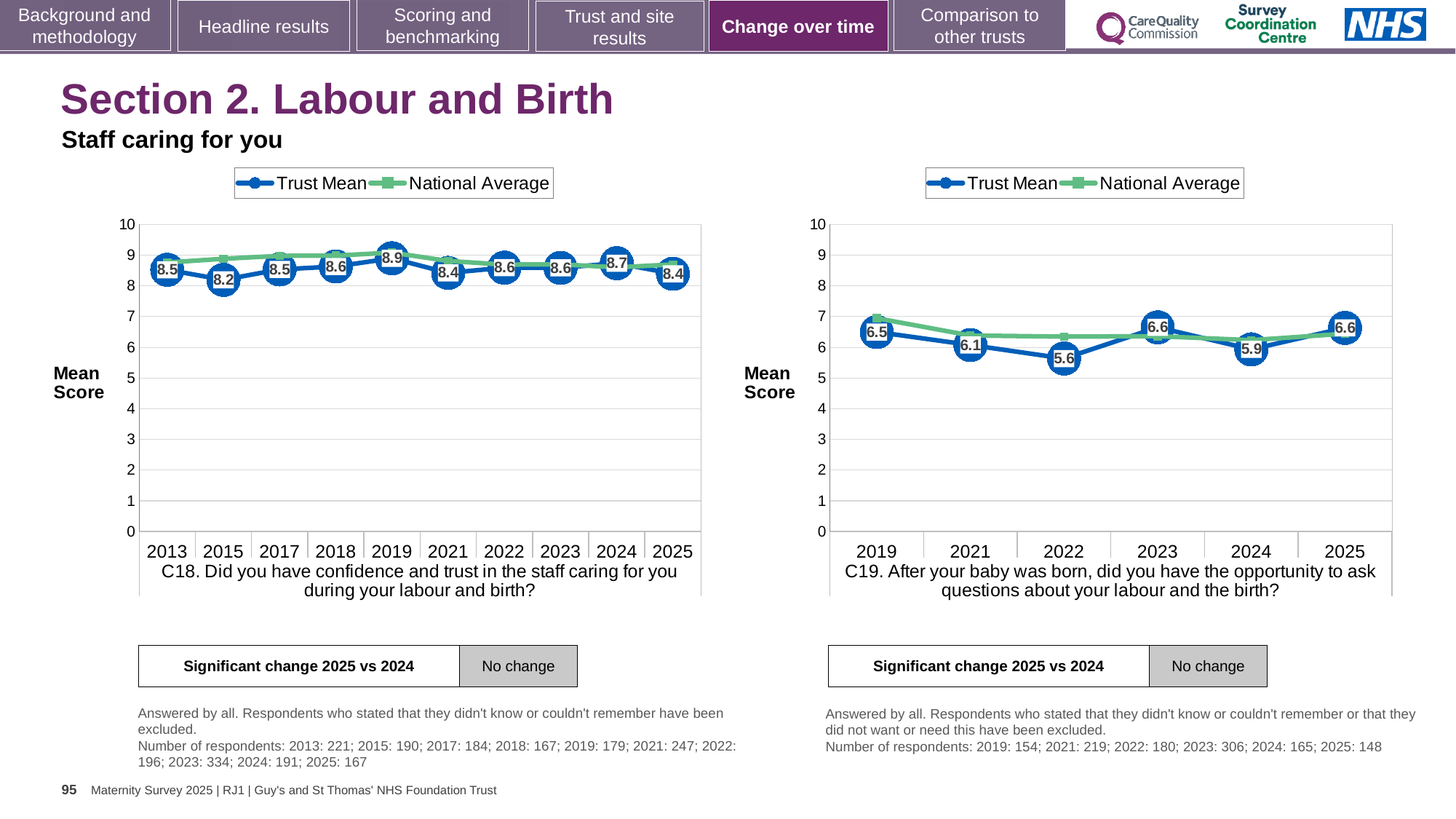
In the right chart (C19), what is the Trust Mean for 2022? 5.6 In the left chart (C18), which year has the highest Trust Mean? 2019 In the left chart (C18), which year has the lowest Trust Mean? 2015 In the right chart (C19), what is the Trust Mean for 2024? 5.9 In the left chart (C18), what is the Trust Mean for 2025? 8.4 How many series does the legend of the left chart (C18) list? 2 How many years are plotted on the x axis of the right chart (C19)? 6 In the right chart (C19), which year has the lowest Trust Mean? 2022 In the right chart (C19), is the National Average value for 2019 greater or less than 6? greater In the left chart (C18), is the Trust Mean for 2024 larger or smaller than for 2025? larger In the right chart (C19), what is the difference between the Trust Mean for 2023 and for 2022? 1.0 In the left chart (C18), what is the Trust Mean for 2019? 8.9